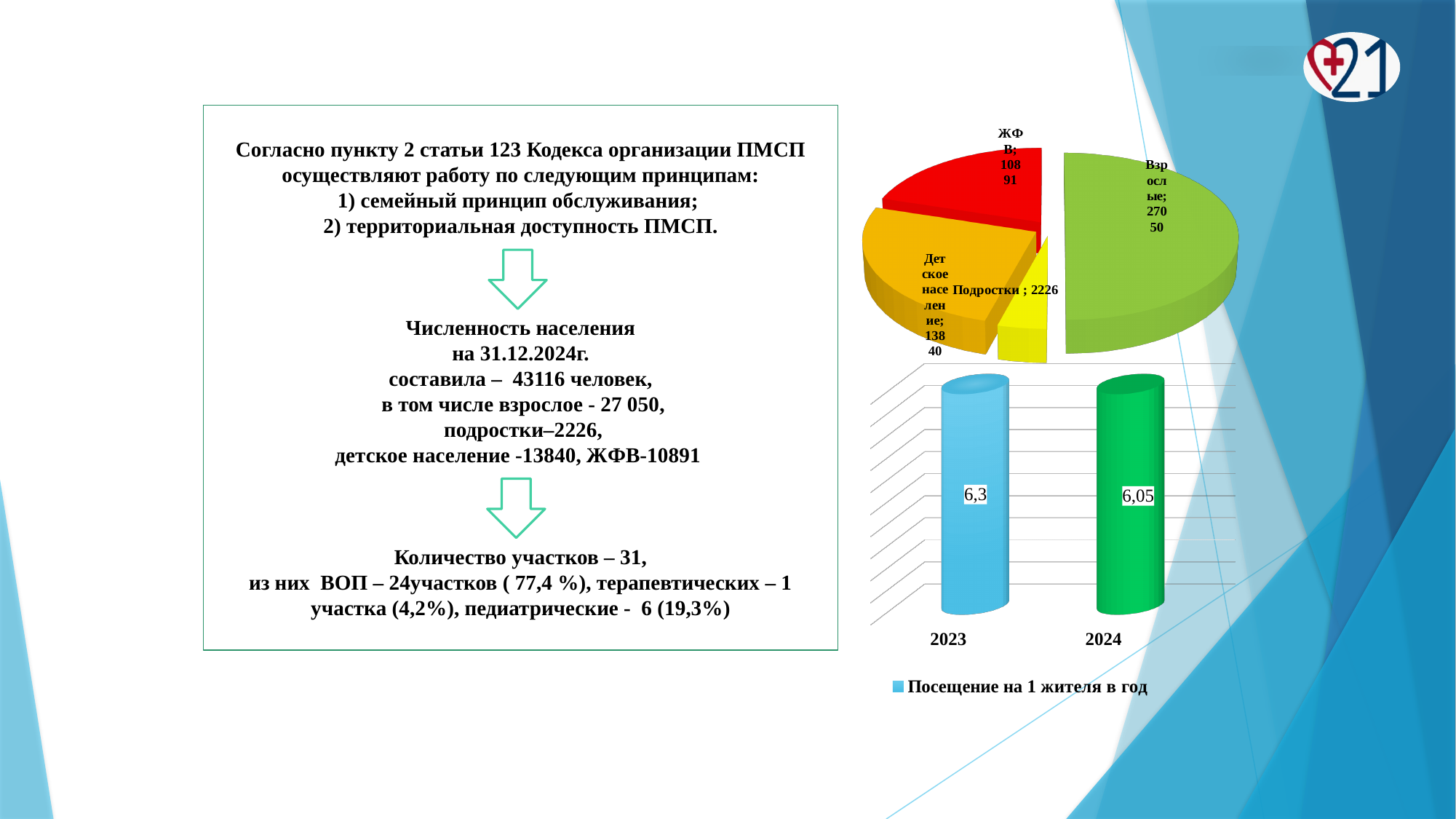
In the pie chart at the top right, which slice is the largest? Взрослые In the pie chart at the top right, what value is shown for the Подростки slice? 2226 In the pie chart at the top right, what value is shown for the Детское население slice? 13840 In the pie chart at the top right, what value is shown for the Взрослые slice? 27050 In the bar chart at the bottom right, what is the value for 2023? 6,3 In the pie chart at the top right, how many slices are there? 4 In the pie chart at the top right, what is the difference between the Детское население and ЖФВ values? 2949 In the bar chart at the bottom right, what is the value for 2024? 6,05 In the bar chart at the bottom right, what series name does the legend show? Посещение на 1 жителя в год In the bar chart at the bottom right, which year has the higher value, 2023 or 2024? 2023 In the pie chart at the top right, what value is shown for the ЖФВ slice? 10891 In the pie chart at the top right, which slice is the smallest? Подростки